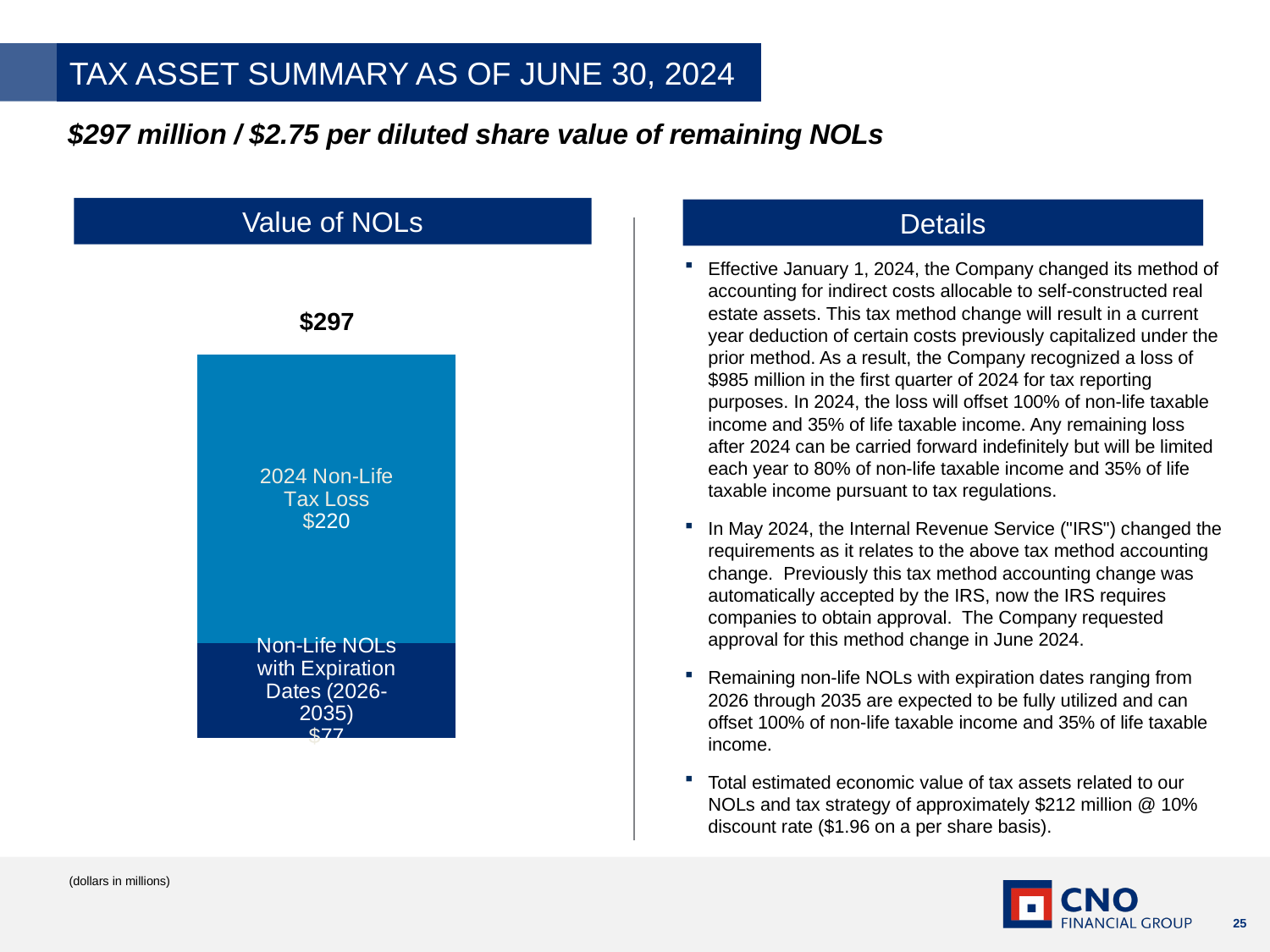
How many segments make up the stacked bar in the Value of NOLs chart? 2 What type of chart is the Value of NOLs chart? Stacked bar chart Which segment in the Value of NOLs chart has the smallest value? Non-Life NOLs with Expiration Dates (2026-2035) Is the value of the 2024 Non-Life Tax Loss segment in the Value of NOLs chart greater or less than 200? greater What is the value of the 2024 Non-Life Tax Loss segment in the Value of NOLs chart? $220 What is the value of the Non-Life NOLs with Expiration Dates (2026-2035) segment in the Value of NOLs chart? $77 What is the total value shown at the top of the stacked bar in the Value of NOLs chart? $297 What is the difference between the 2024 Non-Life Tax Loss segment and the Non-Life NOLs with Expiration Dates (2026-2035) segment in the Value of NOLs chart? $143 Which segment in the Value of NOLs chart has the largest value? 2024 Non-Life Tax Loss In what units are the values in the Value of NOLs chart expressed, according to the note on the slide? Dollars in millions What is the title of the chart on the left side of the slide? Value of NOLs Which segment of the Value of NOLs bar is larger: 2024 Non-Life Tax Loss or Non-Life NOLs with Expiration Dates (2026-2035)? 2024 Non-Life Tax Loss